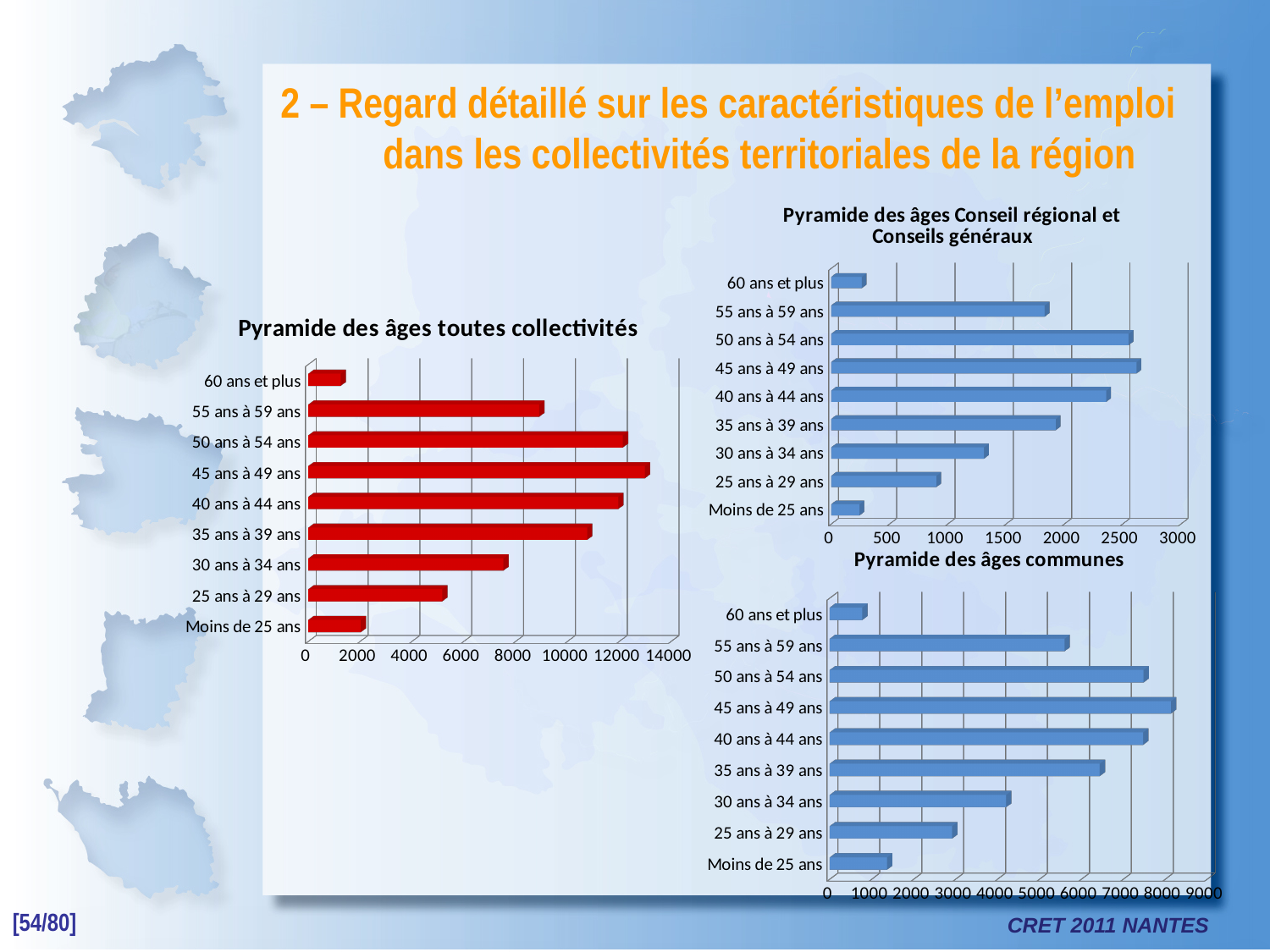
In the "Pyramide des âges communes" chart, which age category has the lowest value? 60 ans et plus In the "Pyramide des âges toutes collectivités" chart, which age category has the lowest value? 60 ans et plus In the "Pyramide des âges Conseil régional et Conseils généraux" chart, is the value for 30 ans à 34 ans greater or less than 1500? less How many age categories are shown in the "Pyramide des âges toutes collectivités" chart? 9 In the "Pyramide des âges toutes collectivités" chart, which is larger: 55 ans à 59 ans or 25 ans à 29 ans? 55 ans à 59 ans What kind of chart is "Pyramide des âges toutes collectivités"? bar chart In the "Pyramide des âges toutes collectivités" chart, is the value for 55 ans à 59 ans greater or less than 8000? greater In the "Pyramide des âges communes" chart, which is larger: 35 ans à 39 ans or 30 ans à 34 ans? 35 ans à 39 ans In the "Pyramide des âges communes" chart, which age category has the highest value? 45 ans à 49 ans In the "Pyramide des âges toutes collectivités" chart, which age category has the highest value? 45 ans à 49 ans In the "Pyramide des âges Conseil régional et Conseils généraux" chart, is the value for 55 ans à 59 ans greater or less than 1500? greater